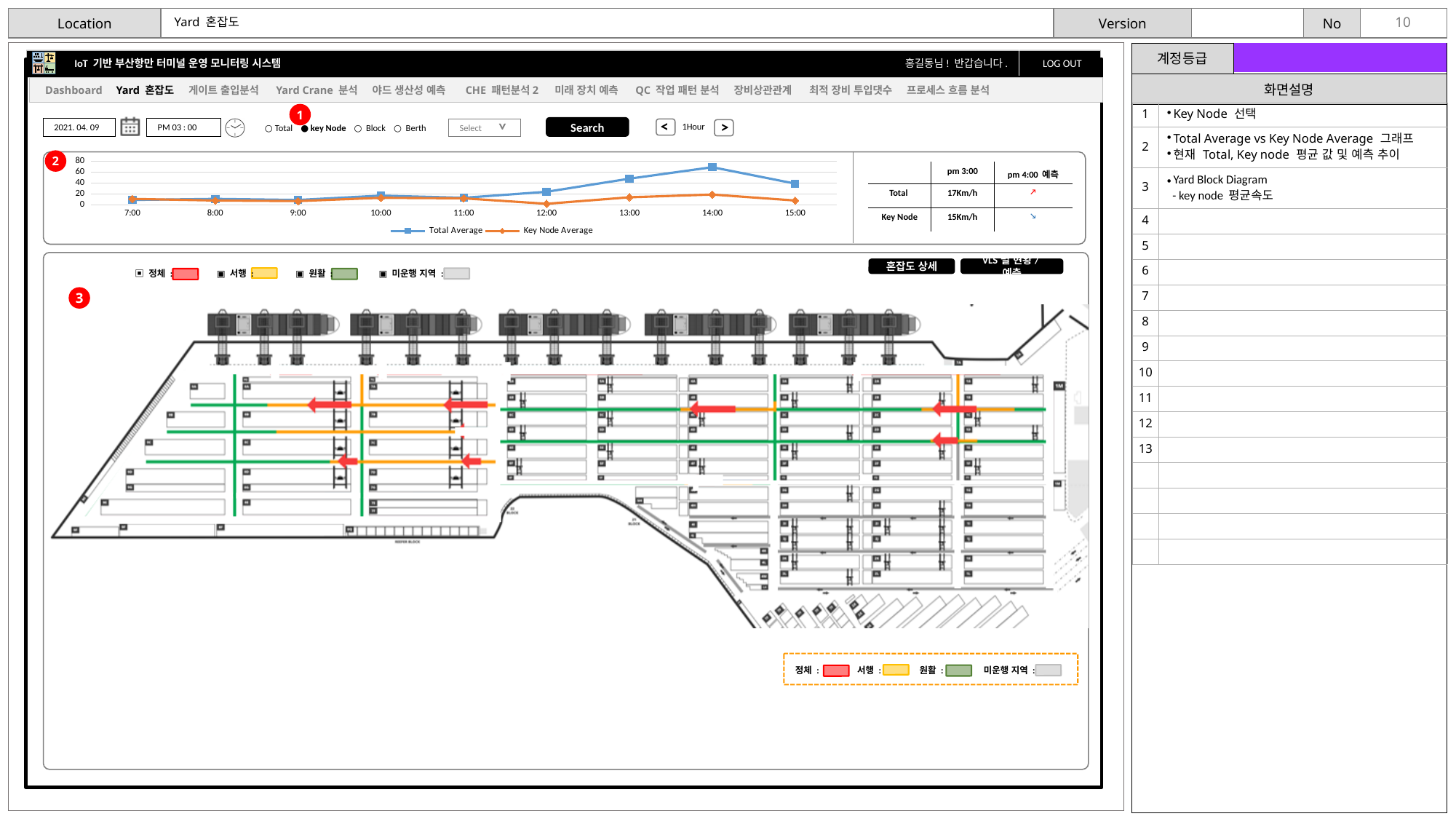
What kind of chart is shown at the top of the slide (the Total Average vs Key Node Average chart)? line chart In the line chart, is the Total Average value at 14:00 greater or less than 40? greater In the line chart, does the Total Average series rise or fall from 14:00 to 15:00? fall How many series does the legend of the line chart list? 2 In the line chart, which series has the larger value at 14:00, Total Average or Key Node Average? Total Average In the line chart, is the Total Average value at 7:00 greater or less than 40? less At which time does the Total Average series reach its highest value in the line chart? 14:00 What are the two series named in the legend of the line chart? Total Average and Key Node Average In the line chart, does the Total Average series rise or fall from 11:00 to 14:00? rise How many time points are plotted along the x axis of the line chart? 9 In the line chart, is the Total Average value larger at 13:00 or at 12:00? 13:00 In the line chart, is the Key Node Average value at 14:00 greater or less than 40? less